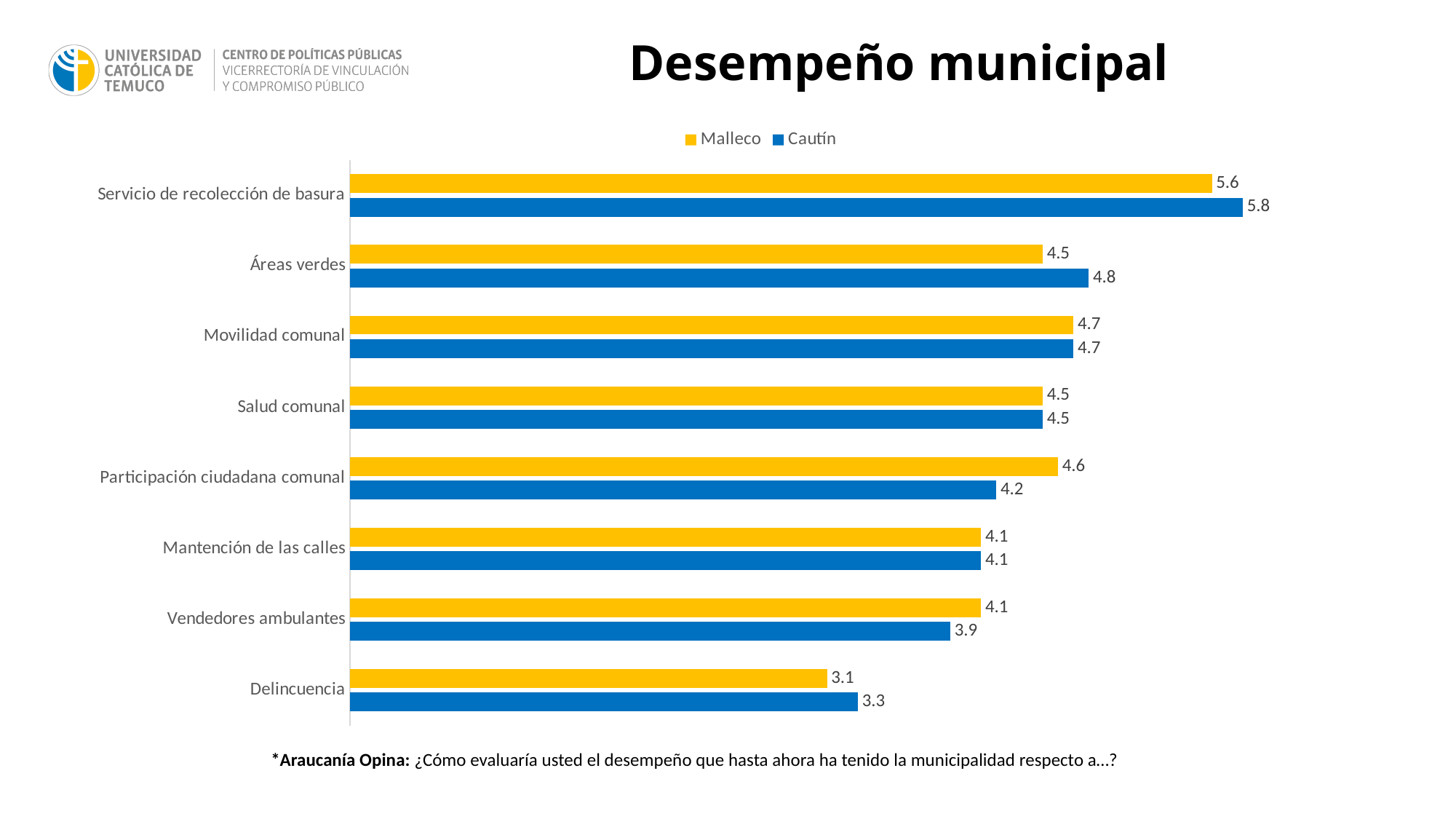
How many series does the legend list? 2 Which is larger for Servicio de recolección de basura, the Malleco value or the Cautín value? Cautín Which is larger for Vendedores ambulantes, the Malleco value or the Cautín value? Malleco What is the Cautín value for Áreas verdes? 4.8 What is the Cautín value for Delincuencia? 3.3 Which category has the highest Cautín value? Servicio de recolección de basura How many categories are shown on the chart? 8 What is the Malleco value for Servicio de recolección de basura? 5.6 Which category has the lowest Malleco value? Delincuencia What is the difference between the Cautín and Malleco values for Áreas verdes? 0.3 What kind of chart is shown on the slide? Bar chart What is the difference between the Cautín and Malleco values for Participación ciudadana comunal? 0.4